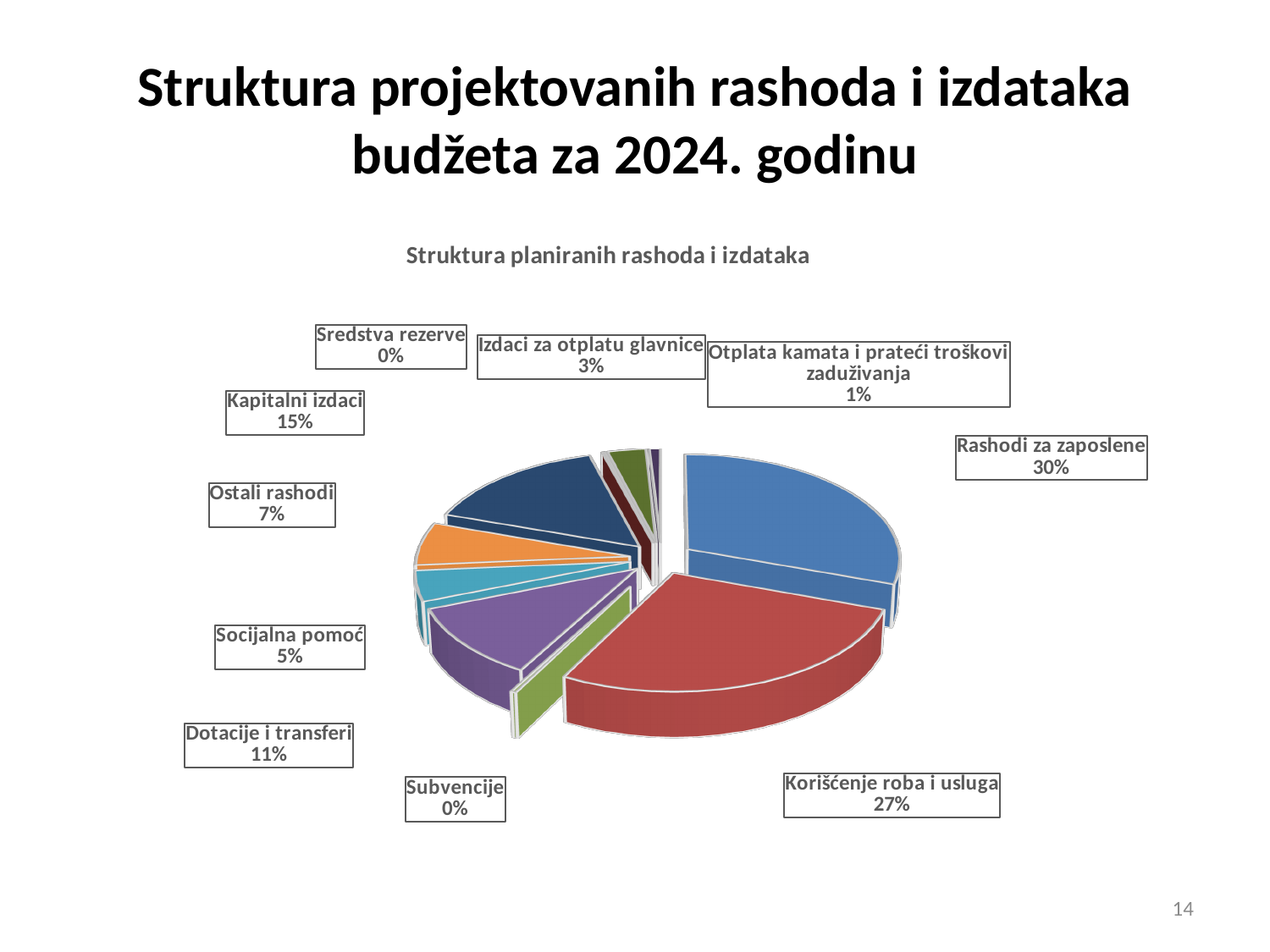
What percentage is shown for Otplata kamata i prateći troškovi zaduživanja? 1% Which two categories are labelled with 0%? Subvencije and Sredstva rezerve What kind of chart is shown on the slide? Pie chart How many categories are shown in the pie chart? 10 What is the title of the chart? Struktura planiranih rashoda i izdataka What is the difference in percentage points between Rashodi za zaposlene and Korišćenje roba i usluga? 3 percentage points What share of the pie does Rashodi za zaposlene represent? 30% What share of the pie does Korišćenje roba i usluga represent? 27% What percentage is shown for Kapitalni izdaci? 15% Which category has the largest share of the pie? Rashodi za zaposlene What percentage is shown for Dotacije i transferi? 11% Which is larger, the share for Ostali rashodi or the share for Socijalna pomoć? Ostali rashodi